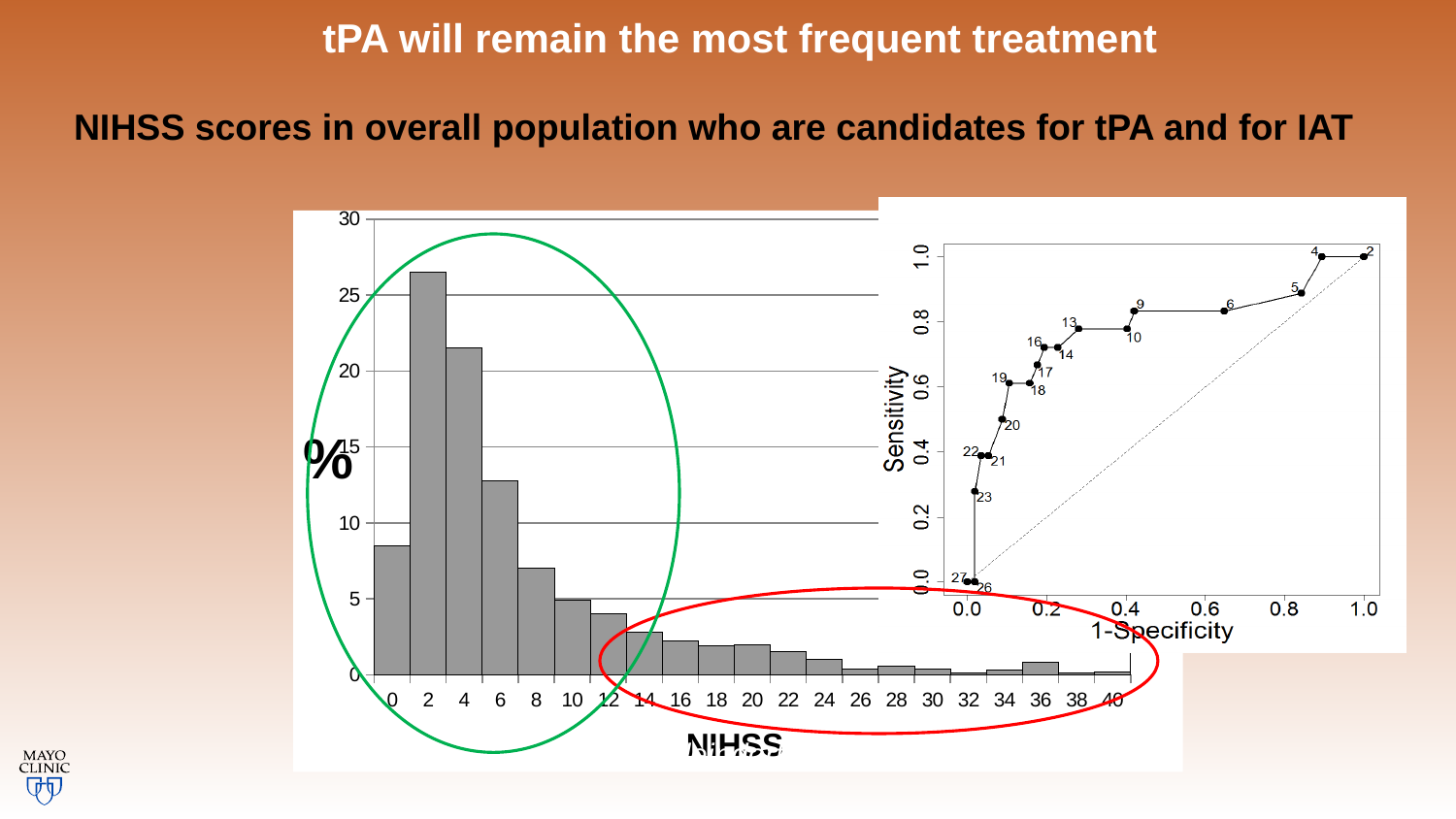
In the NIHSS bar chart, is the value for the bar at NIHSS 4 greater or less than 20? greater In the NIHSS bar chart, do the bar heights rise or fall as NIHSS increases from 2 to 14? fall What is the label of the y-axis of the NIHSS bar chart? % What kind of chart is the left chart with the NIHSS x-axis? bar chart In the NIHSS bar chart, is the value for the bar at NIHSS 2 greater or less than 25? greater In the NIHSS bar chart, is the value for the bar at NIHSS 8 greater or less than 10? less In the ROC chart on the right, which point has higher sensitivity, the one labelled 5 or the one labelled 13? 5 In the ROC chart on the right, what is the x-axis label? 1-Specificity In the ROC chart on the right, what is the sensitivity of the point labelled 2? 1.0 In the NIHSS bar chart, which bar is taller, the one at NIHSS 6 or the one at NIHSS 10? NIHSS 6 In the NIHSS bar chart, which NIHSS bin has the highest percentage? 2